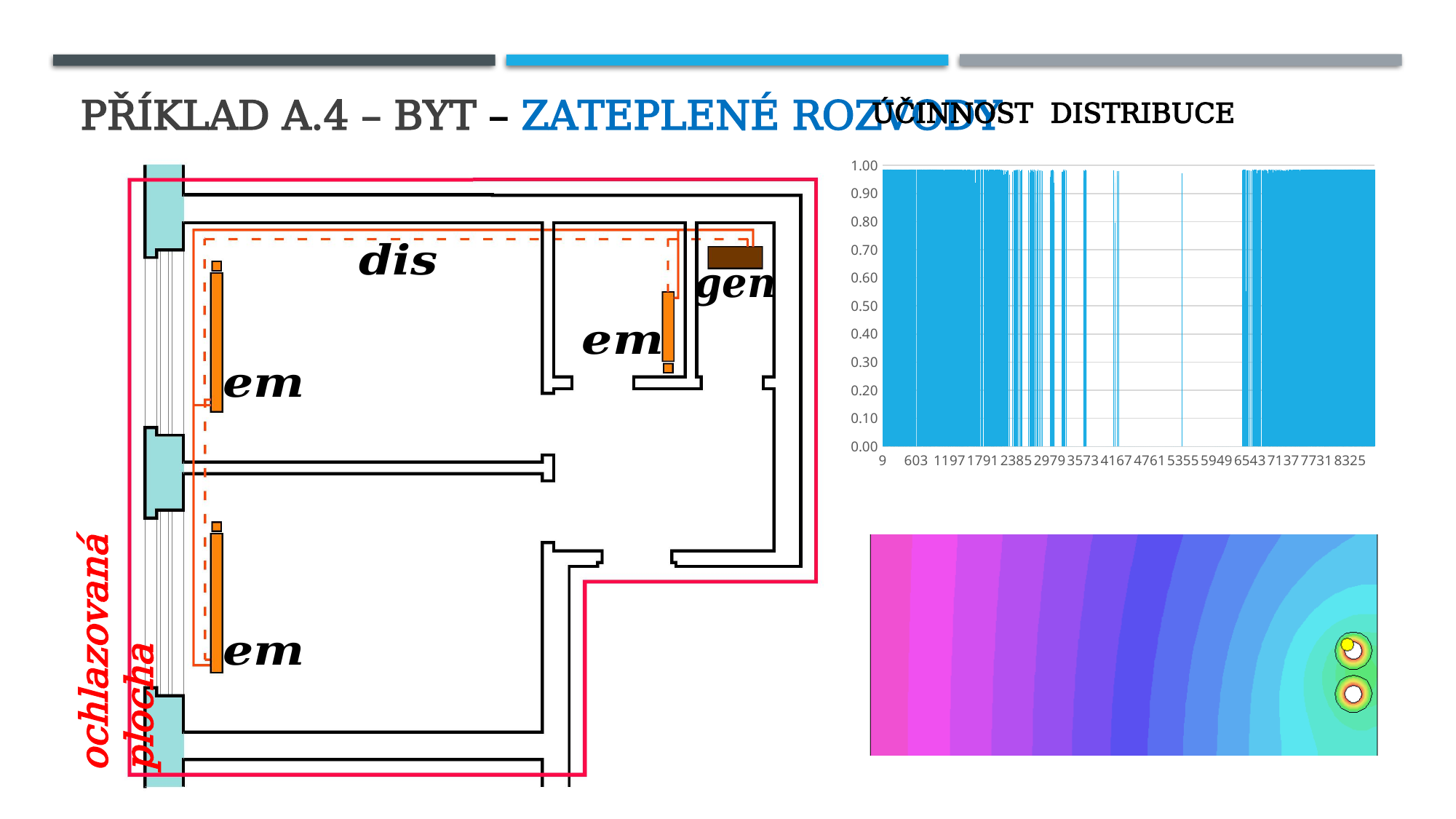
In the "ÚČINNOST DISTRIBUCE" chart, are the values around x = 603 higher or lower than the values around x = 5355? higher How many tick labels are printed along the x axis of the "ÚČINNOST DISTRIBUCE" chart? 15 In the "ÚČINNOST DISTRIBUCE" chart, is the value around x = 4761 greater or less than 0.10? less In the "ÚČINNOST DISTRIBUCE" chart, is the value at the start of the x axis (around 9) greater or less than 0.50? greater What kind of chart is the "ÚČINNOST DISTRIBUCE" chart? bar chart In the "ÚČINNOST DISTRIBUCE" chart, what is the highest value shown on the y axis? 1.00 In the "ÚČINNOST DISTRIBUCE" chart, is the value around x = 7731 greater or less than 0.90? greater In the "ÚČINNOST DISTRIBUCE" chart, do the values fall or rise when moving from x = 1791 to x = 4167? fall What is the title of the chart on the right side of the slide? ÚČINNOST DISTRIBUCE